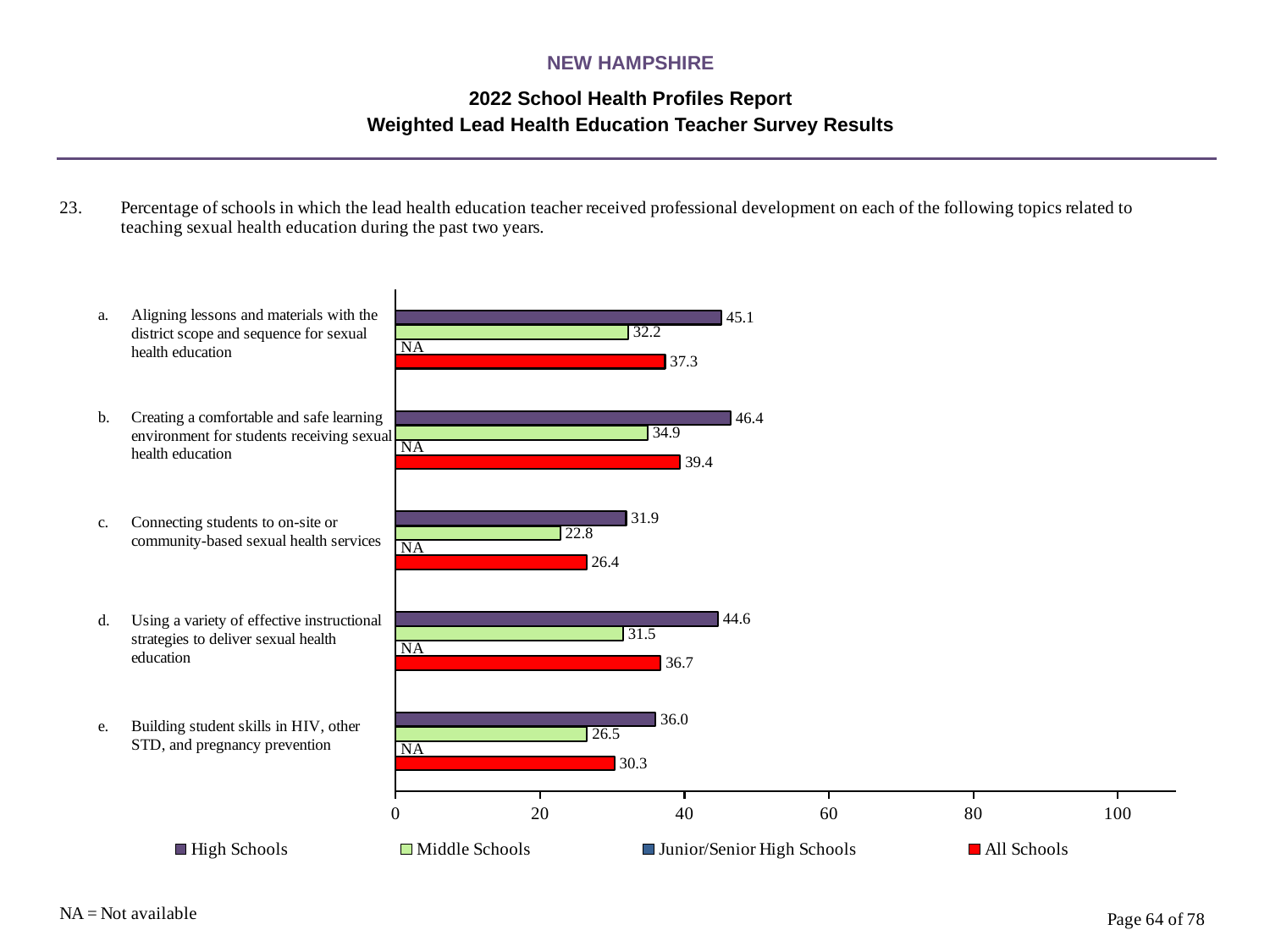
Which topic has the lowest All Schools value? Connecting students to on-site or community-based sexual health services What is the Middle Schools value for 'Connecting students to on-site or community-based sexual health services'? 22.8 How many topics are listed on the chart? 5 What is shown for Junior/Senior High Schools for 'Aligning lessons and materials with the district scope and sequence for sexual health education'? NA Which is larger for 'Building student skills in HIV, other STD, and pregnancy prevention': the High Schools value or the All Schools value? High Schools How many series does the legend list? 4 Is the All Schools value for 'Creating a comfortable and safe learning environment for students receiving sexual health education' greater or less than 40? less What kind of chart is shown on the slide? bar chart What is the difference between the High Schools and Middle Schools values for 'Using a variety of effective instructional strategies to deliver sexual health education'? 13.1 What is the High Schools value for 'Creating a comfortable and safe learning environment for students receiving sexual health education'? 46.4 Which topic has the highest High Schools value? Creating a comfortable and safe learning environment for students receiving sexual health education What is the All Schools value for 'Building student skills in HIV, other STD, and pregnancy prevention'? 30.3